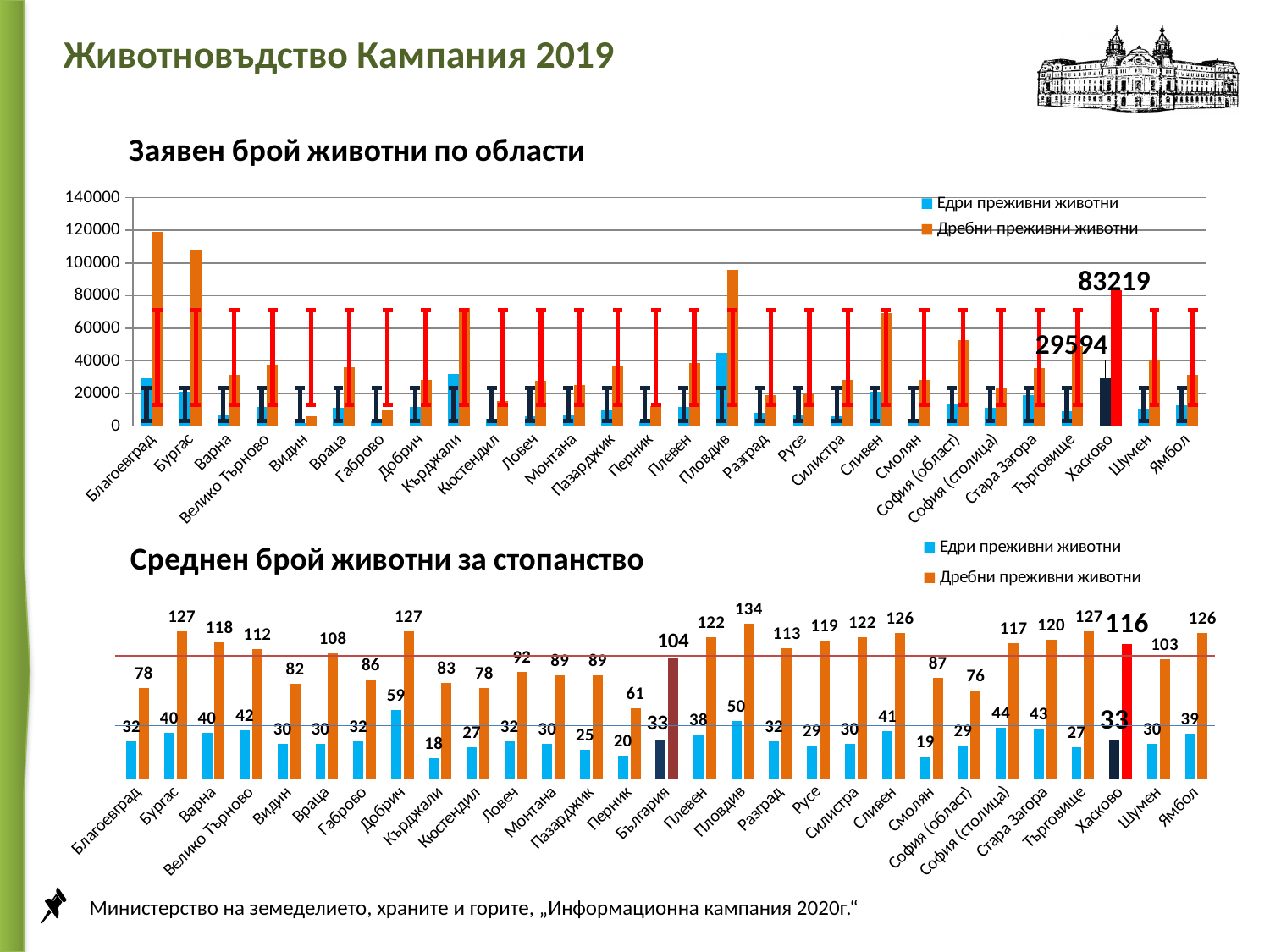
In the chart 'Среднен брой животни за стопанство', which category has the highest value for Едри преживни животни? Добрич What kind of chart is 'Среднен брой животни за стопанство'? bar chart In the chart 'Заявен брой животни по области', what is the value for Дребни преживни животни in Хасково? 83219 In the chart 'Среднен брой животни за стопанство', what is the difference between the Дребни преживни животни values for Бургас and Благоевград? 49 In the chart 'Среднен брой животни за стопанство', which is larger: the Едри преживни животни value for Кърджали or for Смолян? Смолян In the chart 'Заявен брой животни по области', is the value for Дребни преживни животни in Видин greater or less than 20000? less In the chart 'Заявен брой животни по области', how many series does the legend list? 2 In the chart 'Среднен брой животни за стопанство', which region has the lowest value for Дребни преживни животни? Перник In the chart 'Среднен брой животни за стопанство', what is the value for Дребни преживни животни in Пловдив? 134 In the chart 'Заявен брой животни по области', which region has the highest value for Дребни преживни животни? Благоевград In the chart 'Заявен брой животни по области', what is the value for Едри преживни животни in Хасково? 29594 In the chart 'Заявен брой животни по области', is the value for Дребни преживни животни in Бургас greater or less than 100000? greater